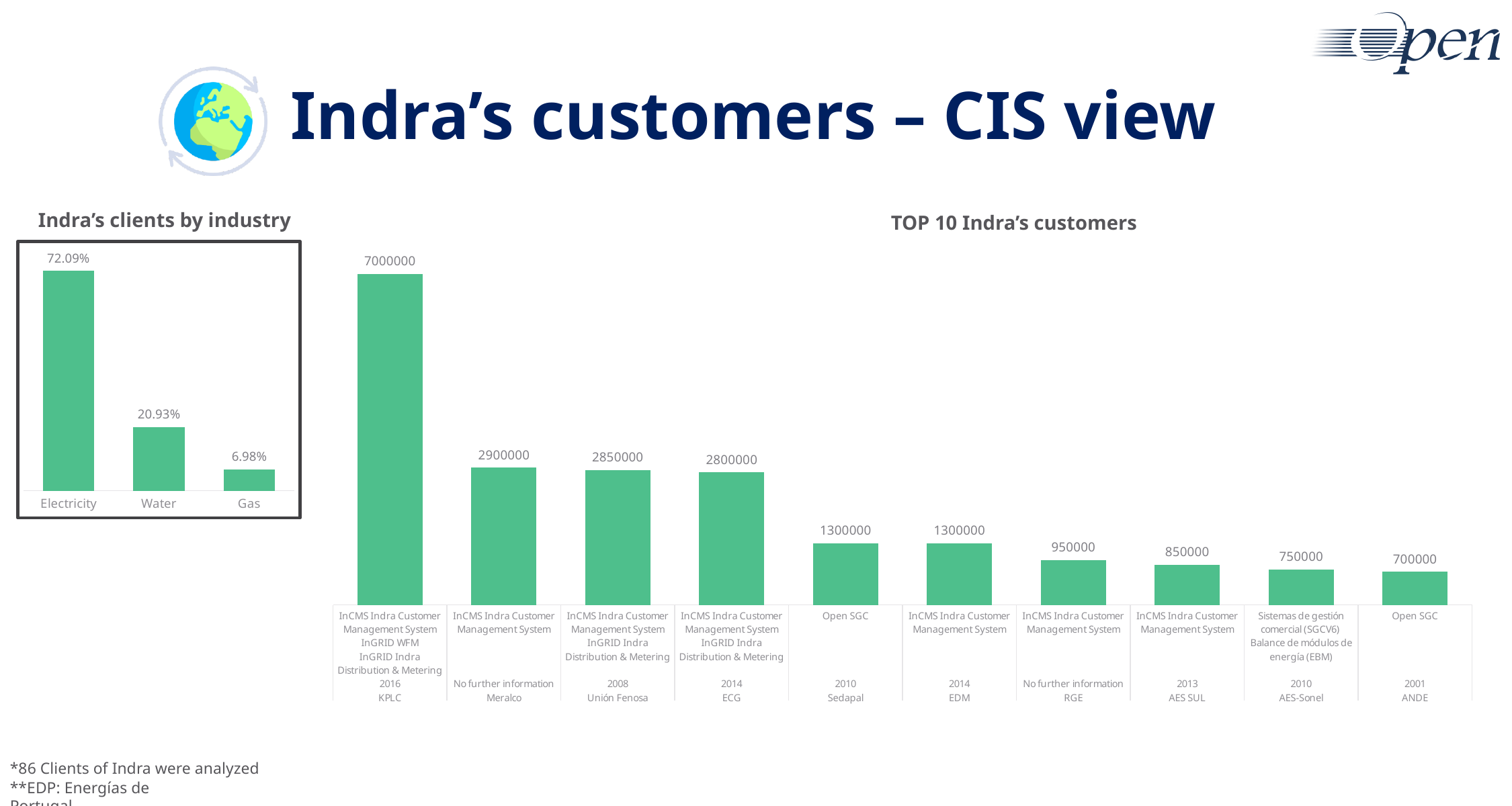
In the 'TOP 10 Indra's customers' chart, what is the value for AES SUL? 850000 In the 'TOP 10 Indra's customers' chart, which customer has the lowest value? ANDE In the 'TOP 10 Indra's customers' chart, how many customers are shown? 10 In the 'Indra's clients by industry' chart, how many industries are shown? 3 What type of chart is the 'TOP 10 Indra's customers' chart? Bar chart In the 'TOP 10 Indra's customers' chart, what is the difference between the values for Meralco and Unión Fenosa? 50000 In the 'TOP 10 Indra's customers' chart, which is larger, the value for ECG or the value for Sedapal? ECG In the 'TOP 10 Indra's customers' chart, which customer has the highest value? KPLC In the 'Indra's clients by industry' chart, which industry has the lowest share? Gas In the 'Indra's clients by industry' chart, what is the difference between the Water and Gas values? 13.95% In the 'Indra's clients by industry' chart, what is the value for Electricity? 72.09% In the 'TOP 10 Indra's customers' chart, what is the value for KPLC? 7000000